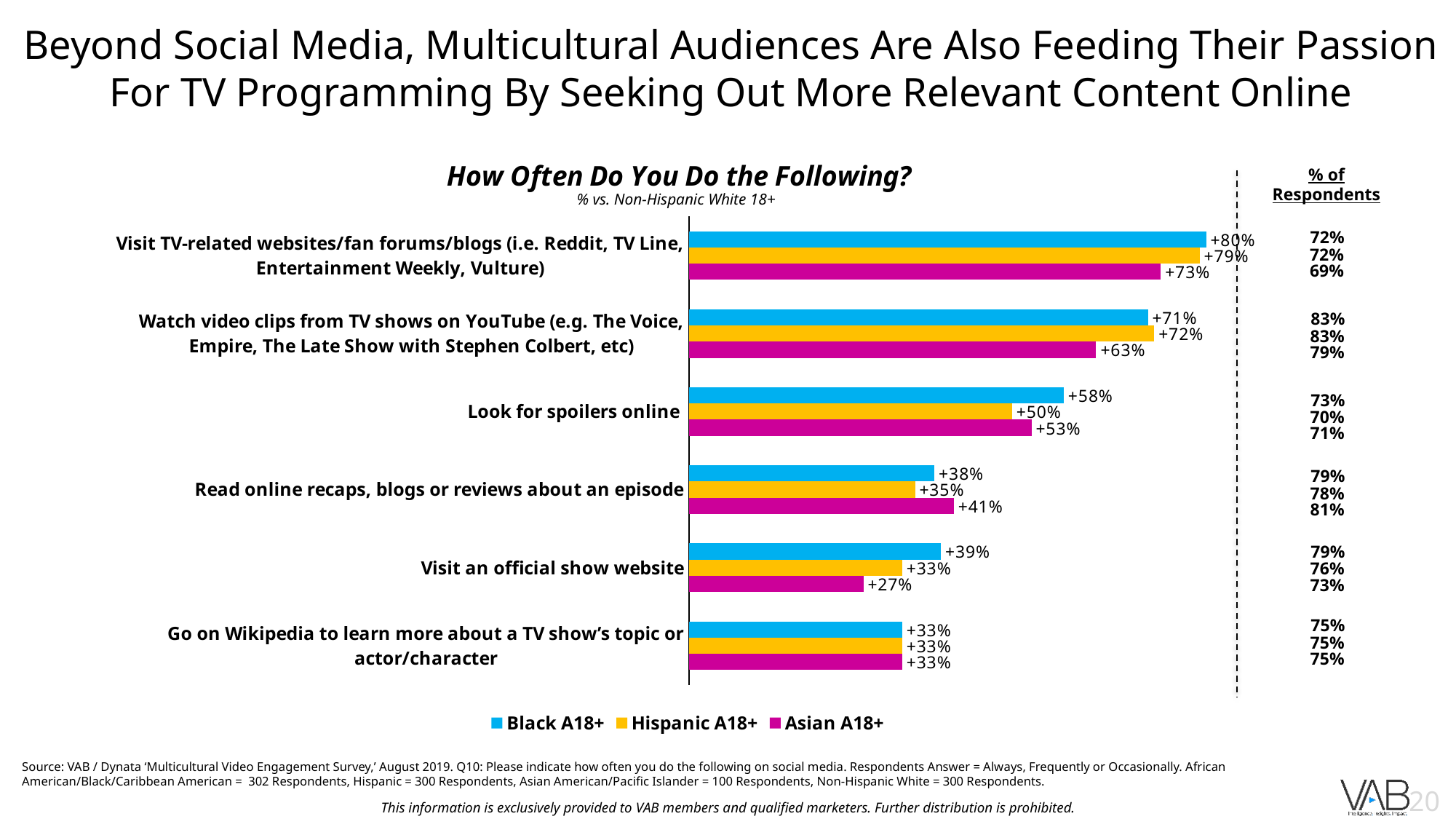
Which colour represents Hispanic A18+ in the chart? Yellow What is the difference between the Black A18+ and Hispanic A18+ values for 'Look for spoilers online'? 8 percentage points What is the value for Asian A18+ for 'Visit an official show website'? +27% What is the value for Black A18+ for 'Look for spoilers online'? +58% How many series does the legend list? 3 What is the title of the chart? How Often Do You Do the Following? What is the value for Hispanic A18+ for 'Watch video clips from TV shows on YouTube'? +72% Which activity has the highest value for Black A18+? Visit TV-related websites/fan forums/blogs How many activities (categories) are shown in the chart? 6 Which activity has the lowest value for Asian A18+? Visit an official show website For 'Read online recaps, blogs or reviews about an episode', which is larger: the Black A18+ value or the Asian A18+ value? Asian A18+ What kind of chart is shown on the slide? Bar chart